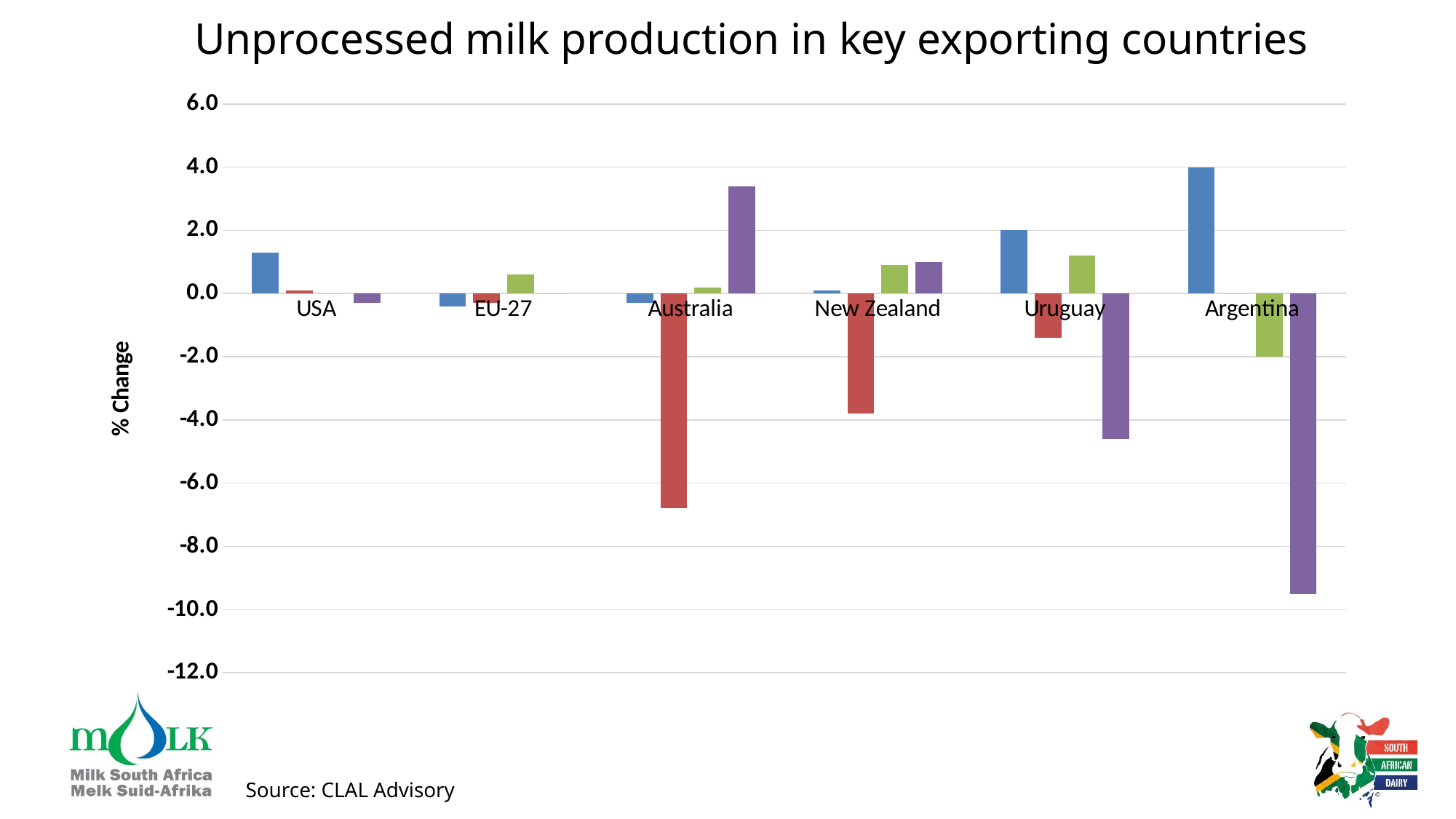
Is the value of the purple bar for Australia greater or less than 2.0? greater Which country has the highest blue bar? Argentina What is the title of the chart? Unprocessed milk production in key exporting countries What kind of chart is shown on the slide? bar chart Is the value of the red bar for Australia greater or less than -6.0? less Which is lower, the red bar for Australia or the red bar for New Zealand? Australia How many countries are shown on the x axis of the chart? 6 Is the value of the purple bar for Argentina greater or less than -8.0? less Which country has the lowest purple bar? Argentina What is the label on the vertical axis of the chart? % Change